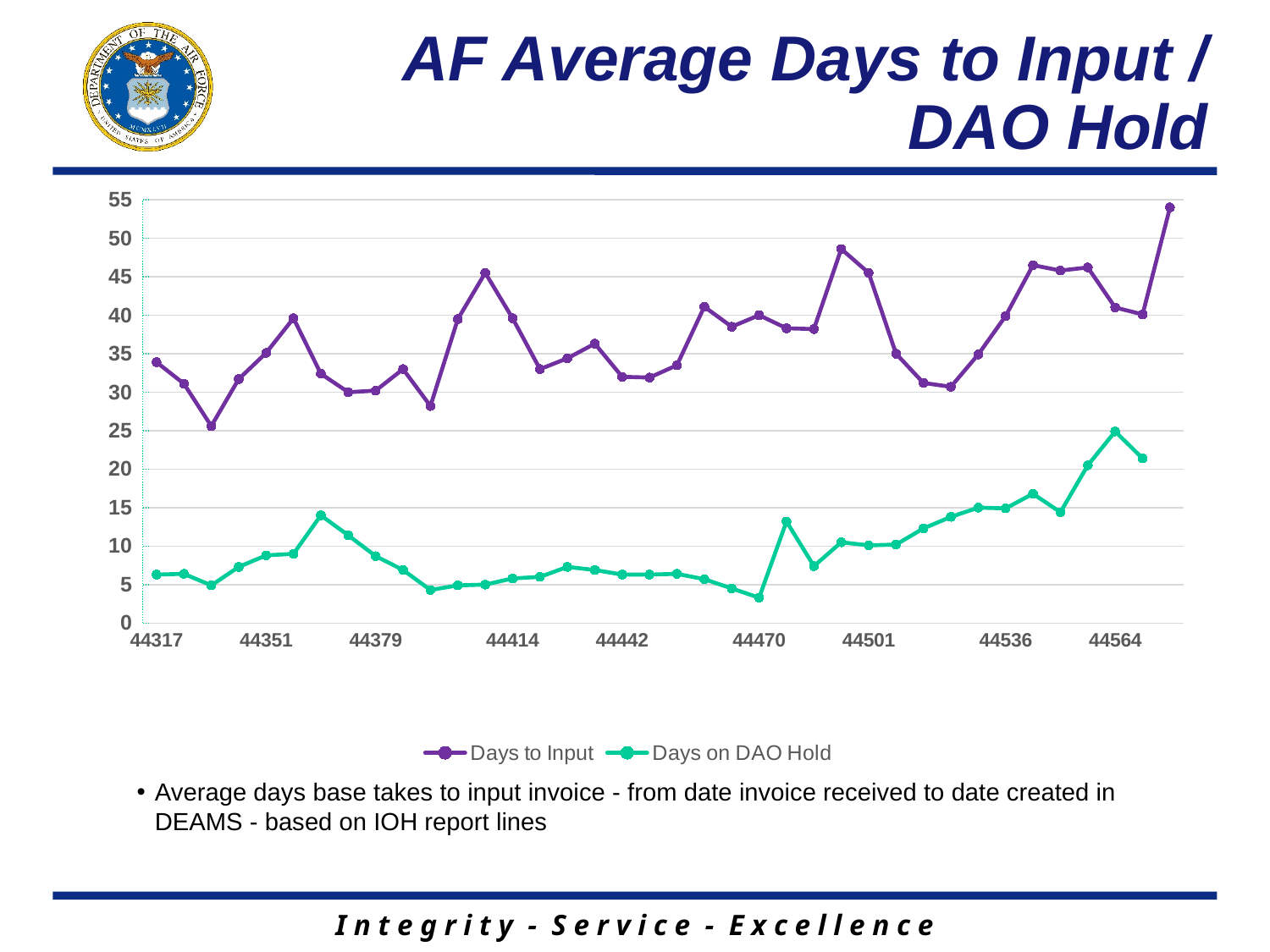
What are the two series named in the legend? Days to Input and Days on DAO Hold What kind of chart is shown on the slide? Line chart Is the value for Days to Input at 44317 greater or less than 30? greater Is the value for Days on DAO Hold at 44564 greater or less than 20? greater At 44317, which series has the larger value, Days to Input or Days on DAO Hold? Days to Input Is the value for Days on DAO Hold at 44317 greater or less than 10? less Which series is drawn in purple? Days to Input How many tick labels are shown on the x axis? 9 How many series does the legend list? 2 Does the Days on DAO Hold series generally rise or fall from 44470 to 44564? Rise